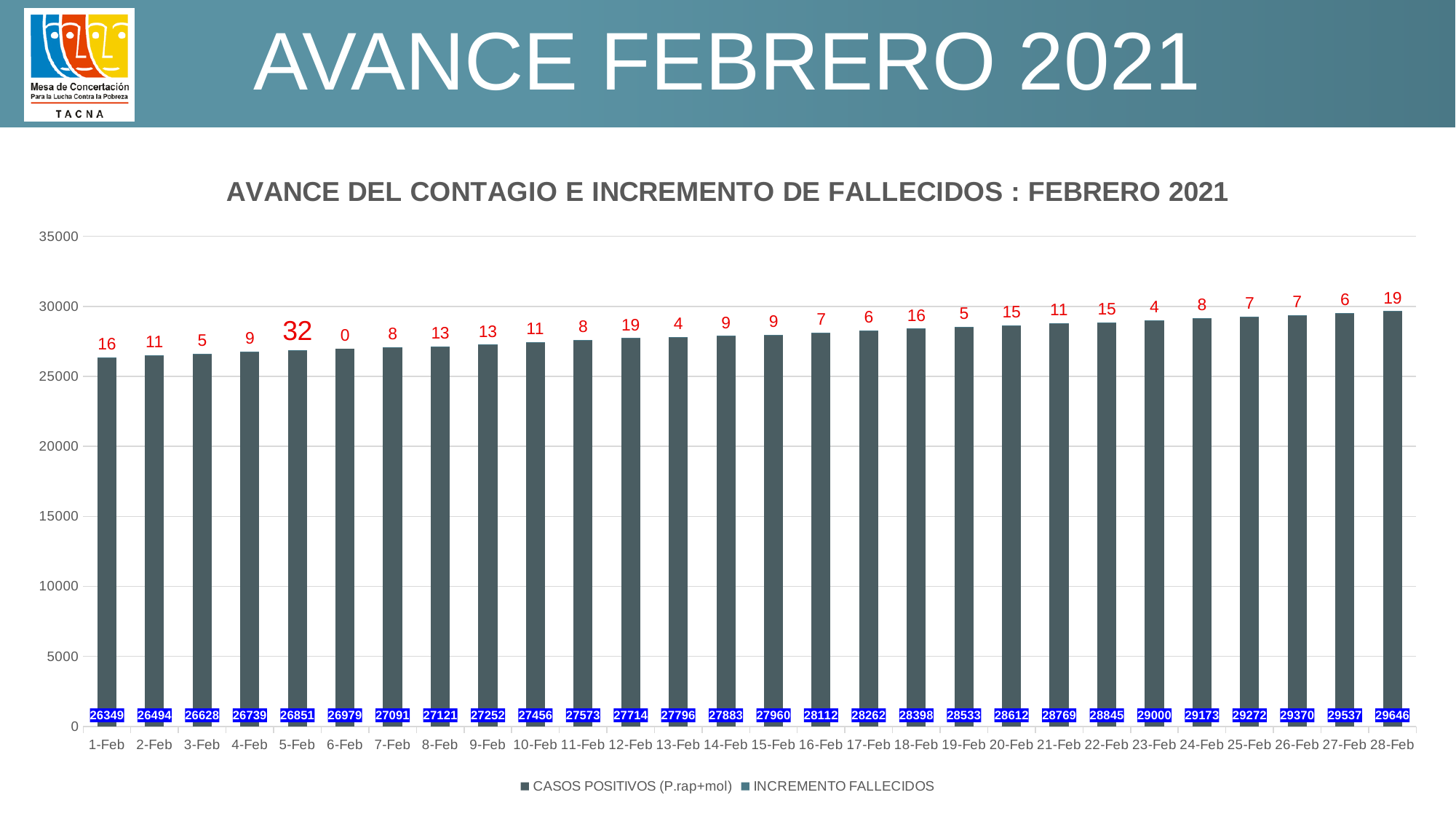
Which date has a larger INCREMENTO FALLECIDOS value, 18-Feb or 19-Feb? 18-Feb What is the value of CASOS POSITIVOS (P.rap+mol) on 1-Feb? 26349 Is the CASOS POSITIVOS (P.rap+mol) value on 15-Feb greater or less than 25000? greater On which date is the INCREMENTO FALLECIDOS value highest? 5-Feb How many dates are shown on the x axis of the chart? 28 Do the CASOS POSITIVOS (P.rap+mol) values rise or fall from 1-Feb to 28-Feb? rise What kind of chart is shown on the slide? bar chart What is the value of CASOS POSITIVOS (P.rap+mol) on 28-Feb? 29646 On which date is the INCREMENTO FALLECIDOS value lowest? 6-Feb How many series does the legend list? 2 What is the INCREMENTO FALLECIDOS value on 5-Feb? 32 By how much did CASOS POSITIVOS (P.rap+mol) increase from 1-Feb to 28-Feb? 3297